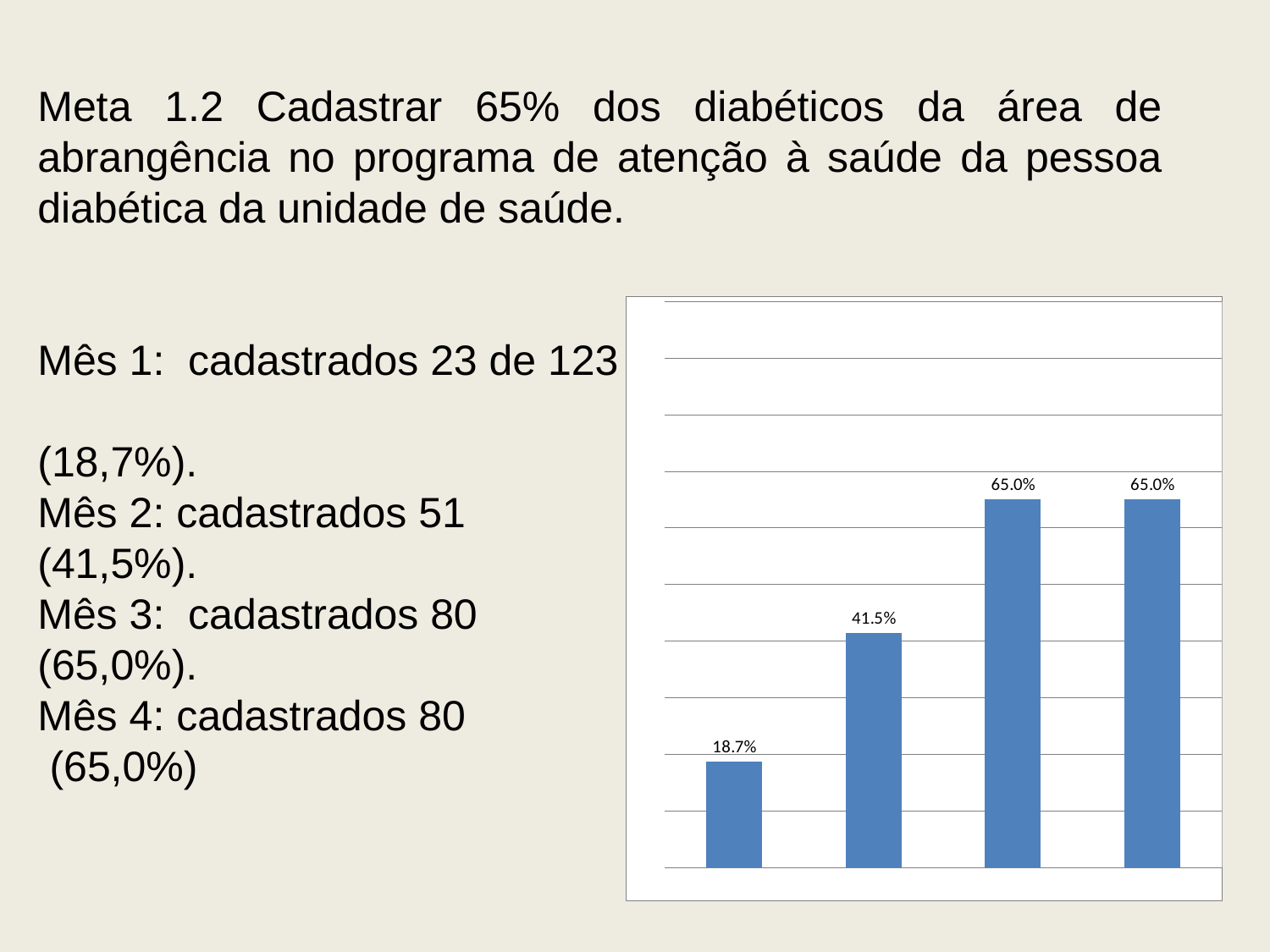
What type of chart is shown on the slide? Bar chart Which is larger, the value of the second bar or the value of the first bar? The second bar How many bars are plotted in the chart? 4 What value is shown on the fourth (rightmost) bar of the chart? 65.0% What value is shown on the second bar of the chart? 41.5% Do the bar values rise or fall from left to right across the chart? Rise What is the difference between the third bar's value and the second bar's value? 23.5% What value is shown on the first (leftmost) bar of the chart? 18.7% Which bars in the chart share the highest value? The third and fourth bars What value is shown on the third bar of the chart? 65.0% Which bar in the chart has the lowest value? The first (leftmost) bar What is the difference between the second bar's value and the first bar's value? 22.8%